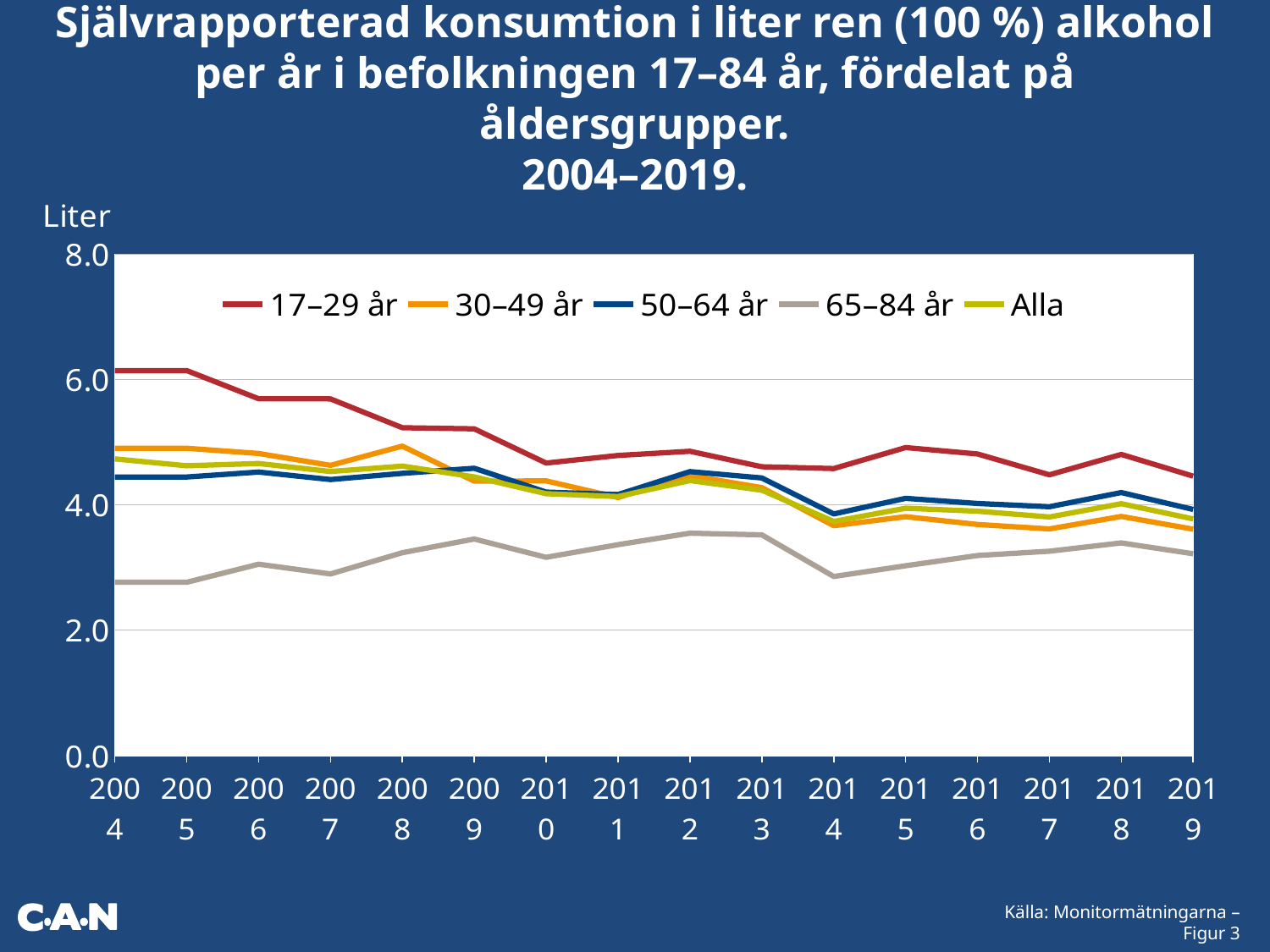
Is the value for 65–84 år in 2004 greater or less than 4.0? less How many years are plotted along the x axis? 16 Is the value for 65–84 år in 2014 greater or less than 4.0? less Which age group has the lowest consumption in 2019? 65–84 år What kind of chart is shown on the slide? Line chart How many series does the legend list? 5 What unit is shown as the label of the vertical axis? Liter Which is larger in 2010, the value for 17–29 år or the value for 65–84 år? 17–29 år Does the consumption for 17–29 år rise or fall from 2004 to 2019? Fall Is the value for 17–29 år in 2019 greater or less than 4.0? greater What colour is the line for 17–29 år? Red Which age group has the highest consumption in 2004? 17–29 år